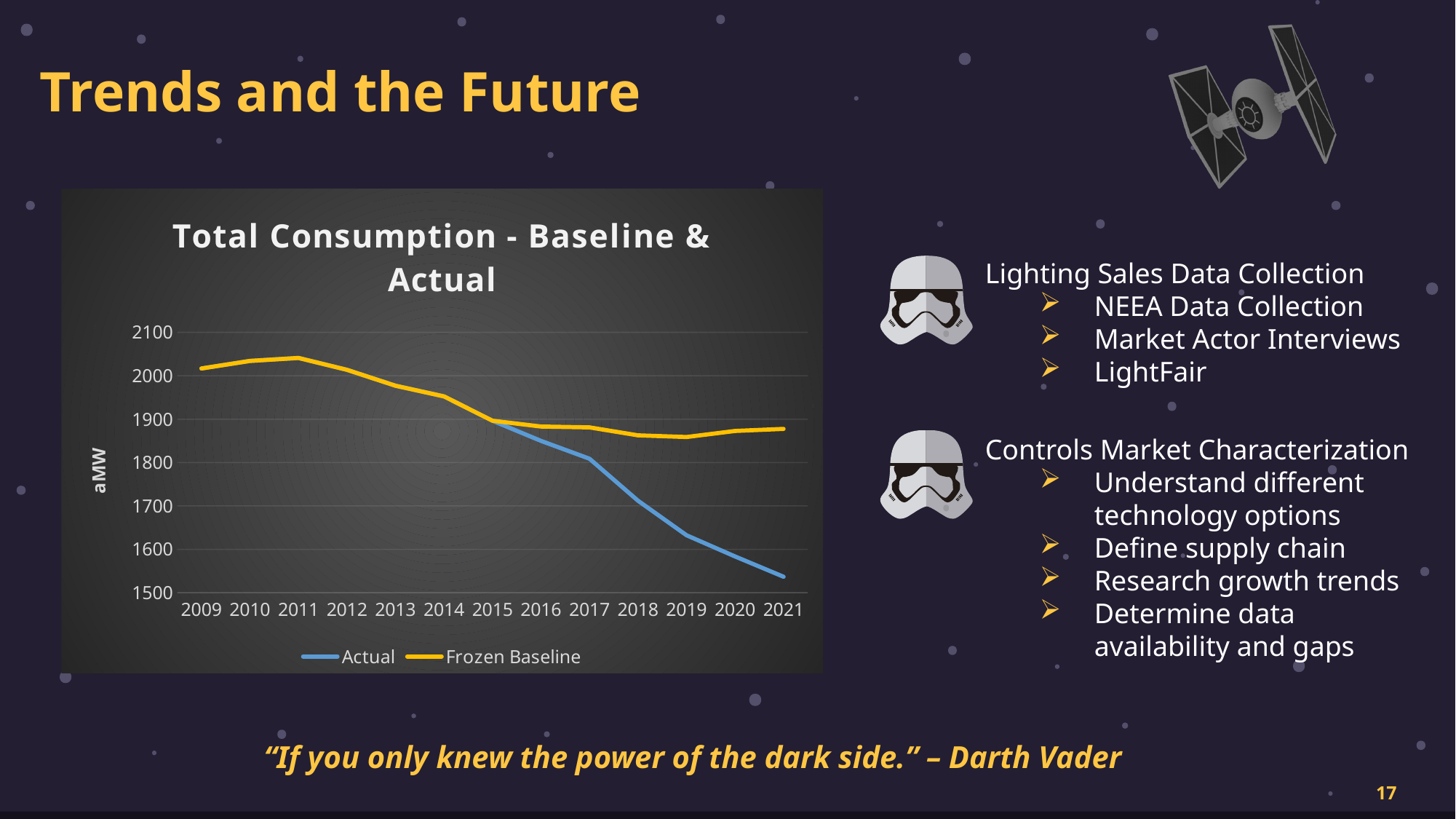
In which year is the Frozen Baseline series at its highest? 2011 What is the label on the chart's y axis? aMW How many years are shown along the x axis of the chart? 13 What kind of chart is shown on the slide? line chart Does the Actual series rise or fall from 2015 to 2021? fall Is the value for Frozen Baseline in 2011 greater or less than 2000? greater Is the value for Actual in 2019 greater or less than 1700? less How many series does the chart's legend list? 2 Is the value for Frozen Baseline in 2019 greater or less than 1900? less In 2021, which series has the larger value, Actual or Frozen Baseline? Frozen Baseline In which year is the Actual series at its lowest? 2021